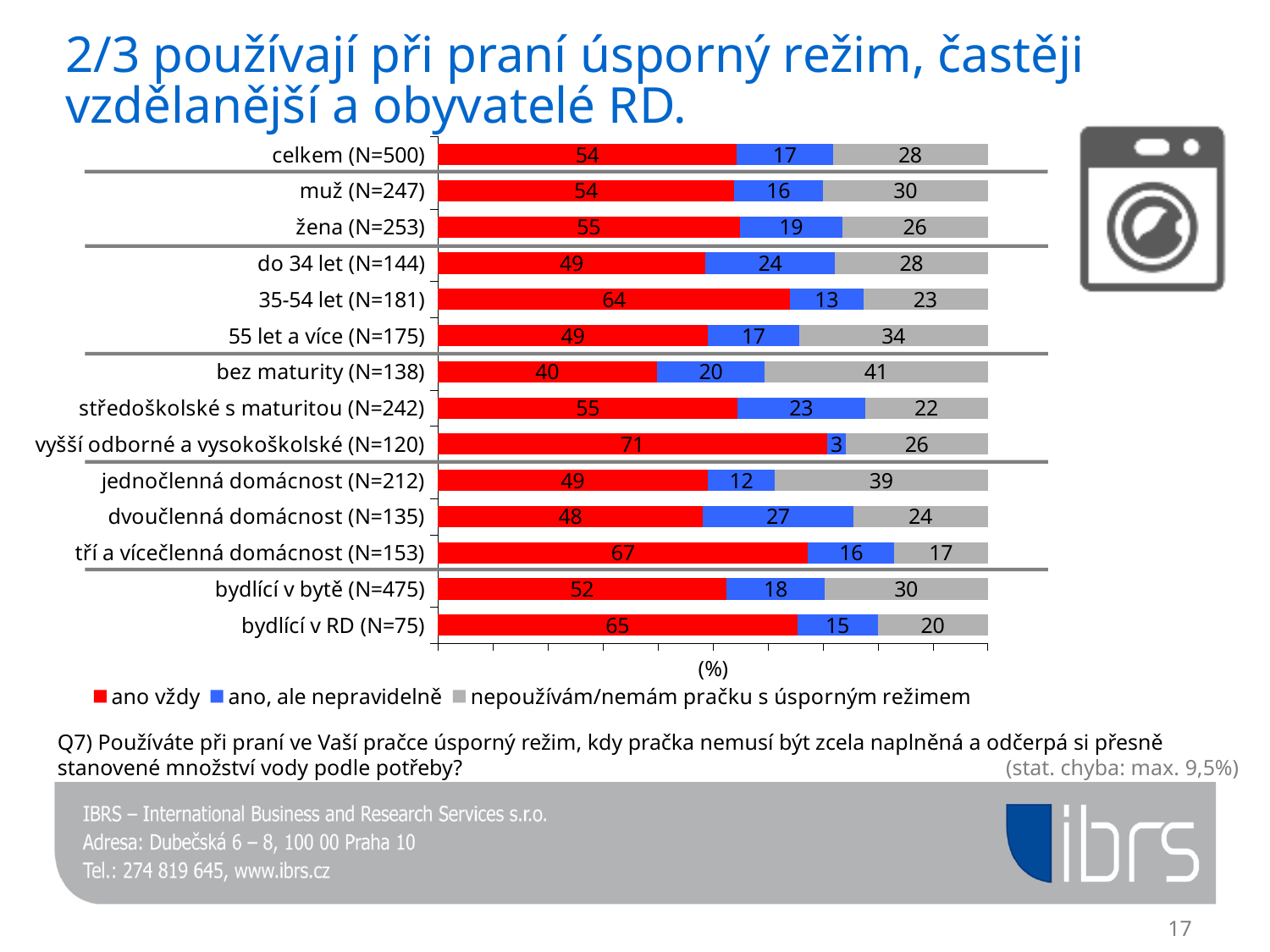
What is the value of 'ano, ale nepravidelně' for 'dvoučlenná domácnost (N=135)'? 27 Which has a larger 'ano vždy' value: '35-54 let (N=181)' or 'do 34 let (N=144)'? 35-54 let (N=181) Which category has the lowest value for 'ano vždy'? bez maturity (N=138) What is the value of 'ano vždy' for 'celkem (N=500)'? 54 How many series does the legend list? 3 Which category has the lowest value for 'ano, ale nepravidelně'? vyšší odborné a vysokoškolské (N=120) What is the difference between the 'ano vždy' values for 'bydlící v RD (N=75)' and 'bydlící v bytě (N=475)'? 13 Which category has the highest value for 'ano vždy'? vyšší odborné a vysokoškolské (N=120) What type of chart is shown on the slide? stacked bar chart How many categories (rows) are plotted in the chart? 14 What is the value of 'nepoužívám/nemám pračku s úsporným režimem' for 'jednočlenná domácnost (N=212)'? 39 What is the total of the stacked bar for '35-54 let (N=181)'? 100